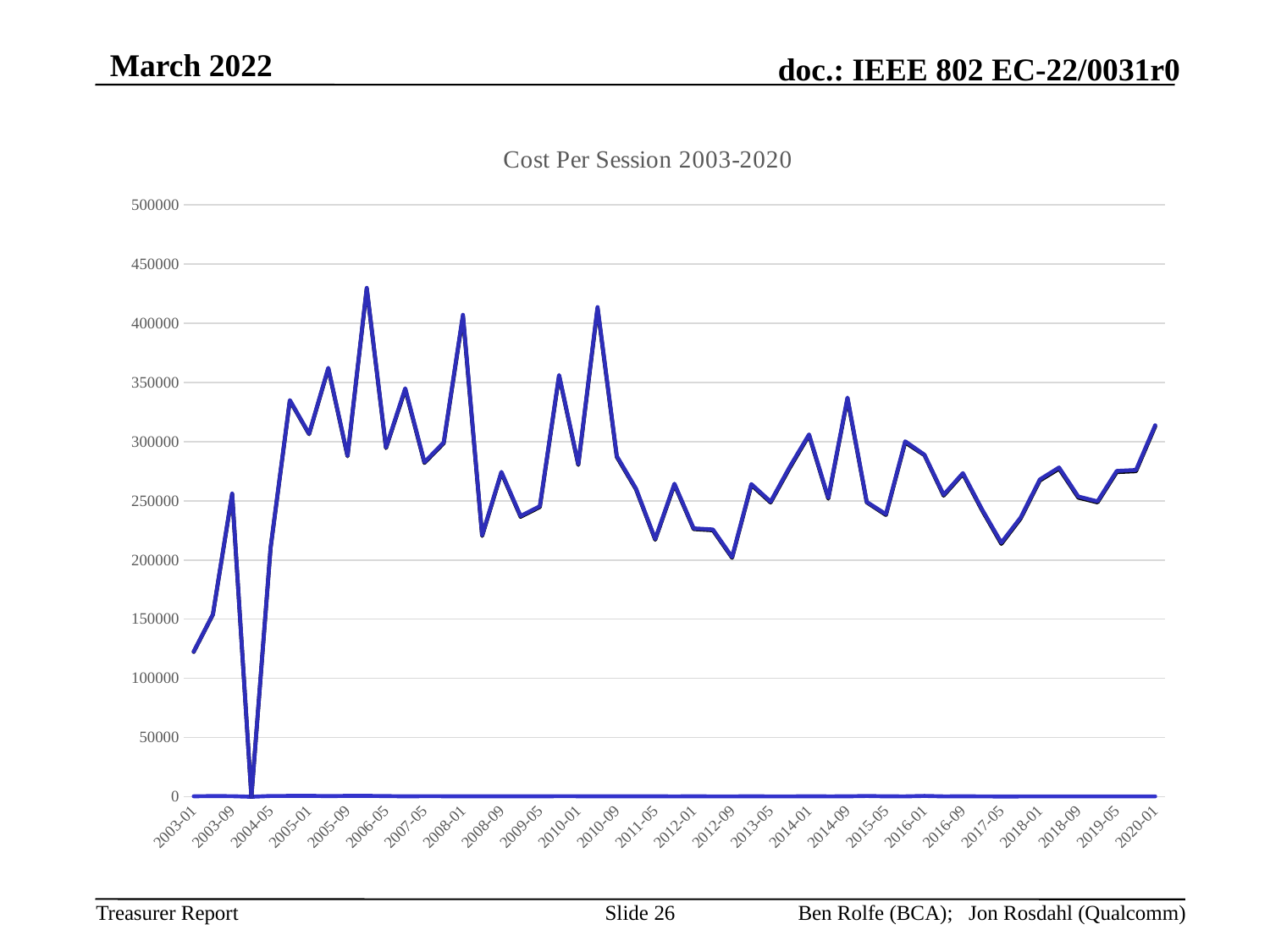
Which has the larger value, 2003-01 or 2020-01? 2020-01 Does the line rise or fall between 2003-01 and 2003-09? rise Is the highest point on the line greater or less than 400000? greater Is the value for 2020-01 greater or less than 250000? greater What is the title of the chart? Cost Per Session 2003-2020 What kind of chart is shown on the slide? line chart What is the highest value shown on the y axis? 500000 Does the line ever exceed 450000? no Does the line rise or fall between 2019-05 and 2020-01? rise